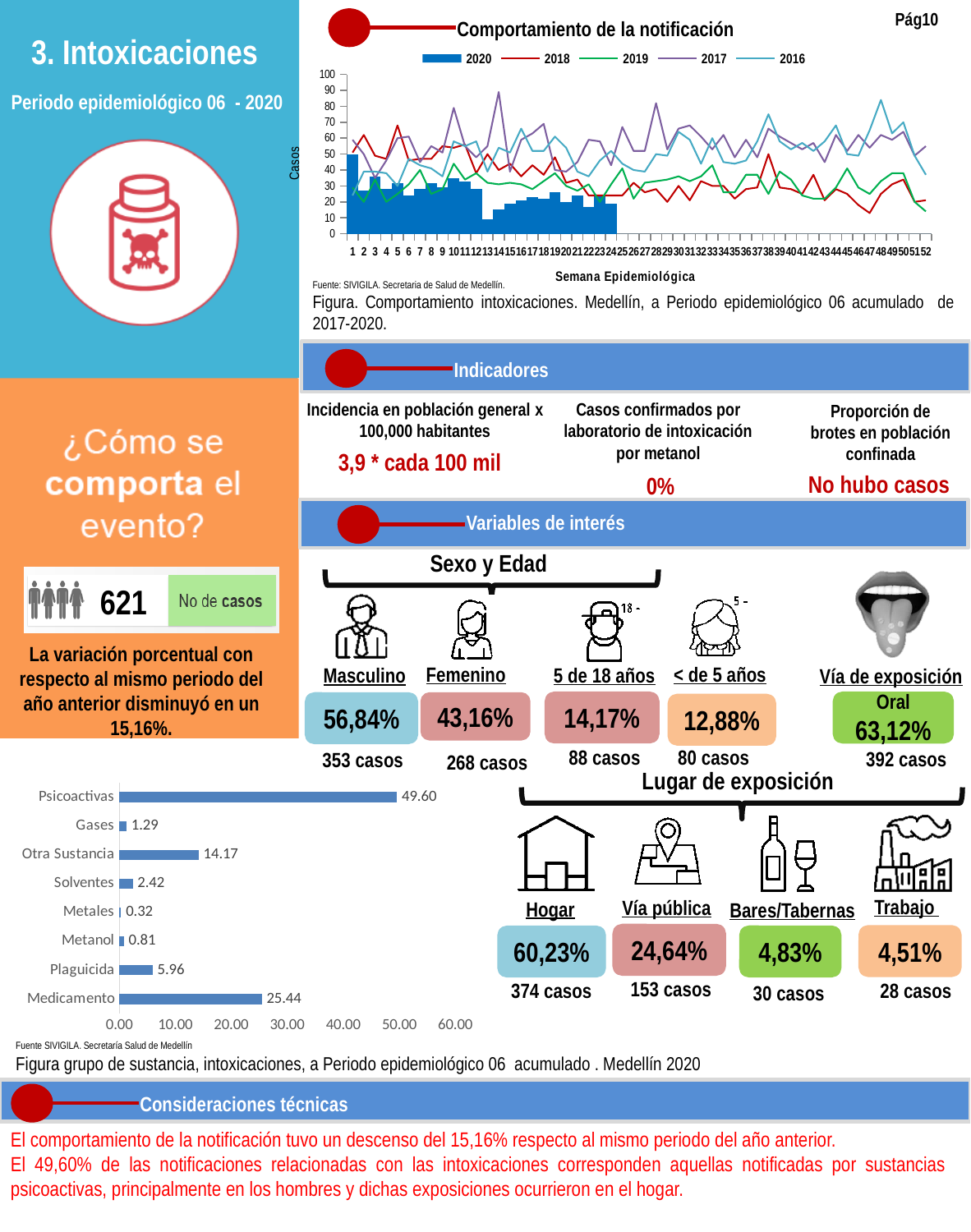
How many categories are shown in the bottom-left bar chart of substance groups? 8 In the bottom-left bar chart of substance groups, which category has the highest value? Psicoactivas In the bottom-left bar chart of substance groups, what is the difference between the values for Psicoactivas and Medicamento? 24.16 In the bottom-left bar chart of substance groups, what is the value for Psicoactivas? 49.60 What is the x-axis label of the 'Comportamiento de la notificación' chart? Semana Epidemiológica In the bottom-left bar chart of substance groups, which category has the lowest value? Metales In the bottom-left bar chart of substance groups, which is larger, Otra Sustancia or Plaguicida? Otra Sustancia In the 'Comportamiento de la notificación' chart, is the value for 2020 at week 1 greater or less than 40? greater How many series does the legend of the 'Comportamiento de la notificación' chart list? 5 What kind of chart is the bottom-left chart of substance groups? Bar chart In the bottom-left bar chart of substance groups, what is the value for Plaguicida? 5.96 In the bottom-left bar chart of substance groups, what is the value for Medicamento? 25.44